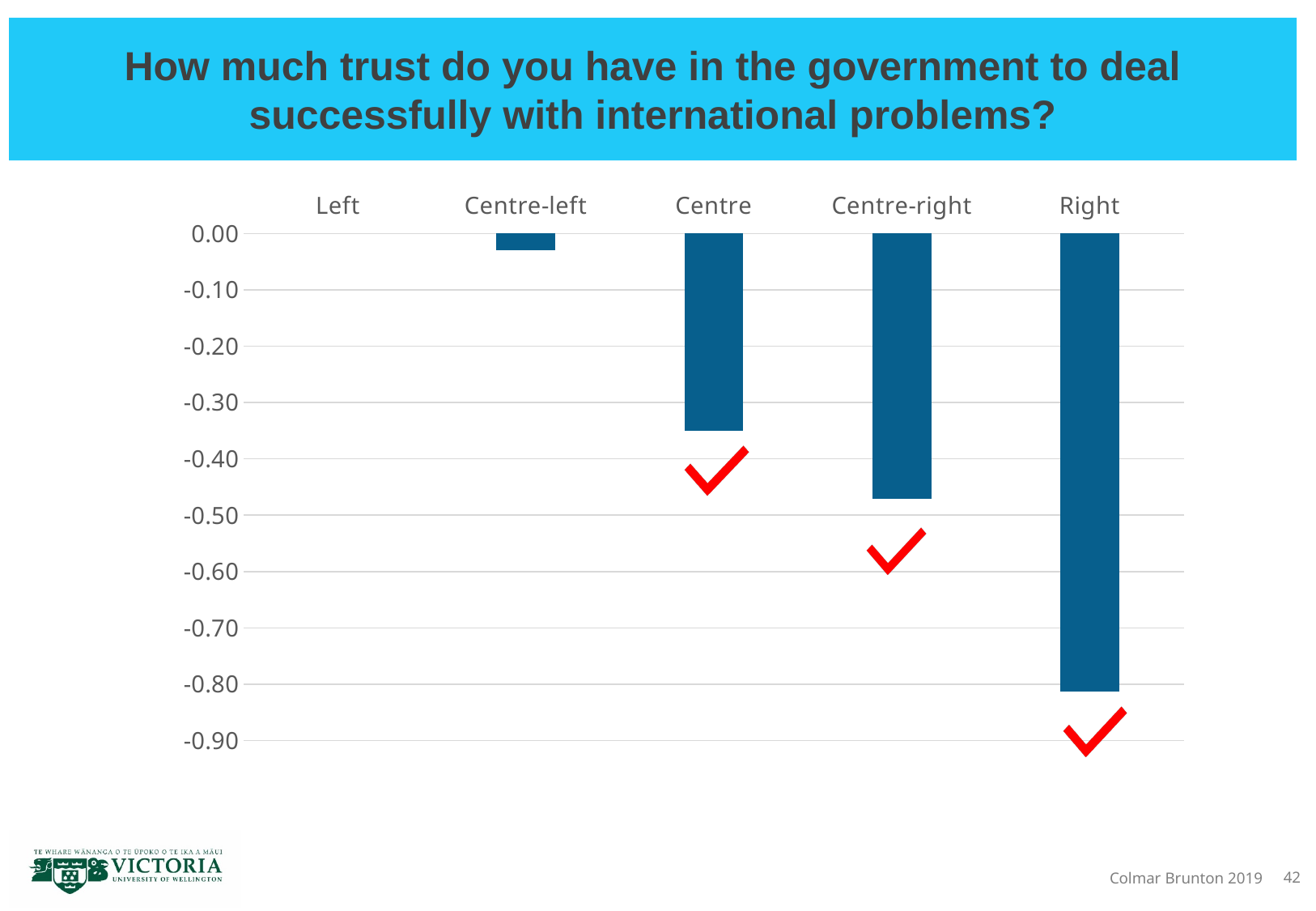
How many categories are shown on the x axis of the chart? 5 How many red check marks are shown beneath the bars? 3 Do the values rise or fall moving from Left to Right along the x axis? Fall Which category has the lowest (most negative) value? Right Is the value for Centre-right greater or less than -0.40? less Is the value for Right greater or less than -0.70? less Is the value for Right greater or less than -0.90? greater Which has the larger (less negative) value, Centre or Centre-right? Centre What kind of chart is shown on the slide? Bar chart Which category has the highest value? Left